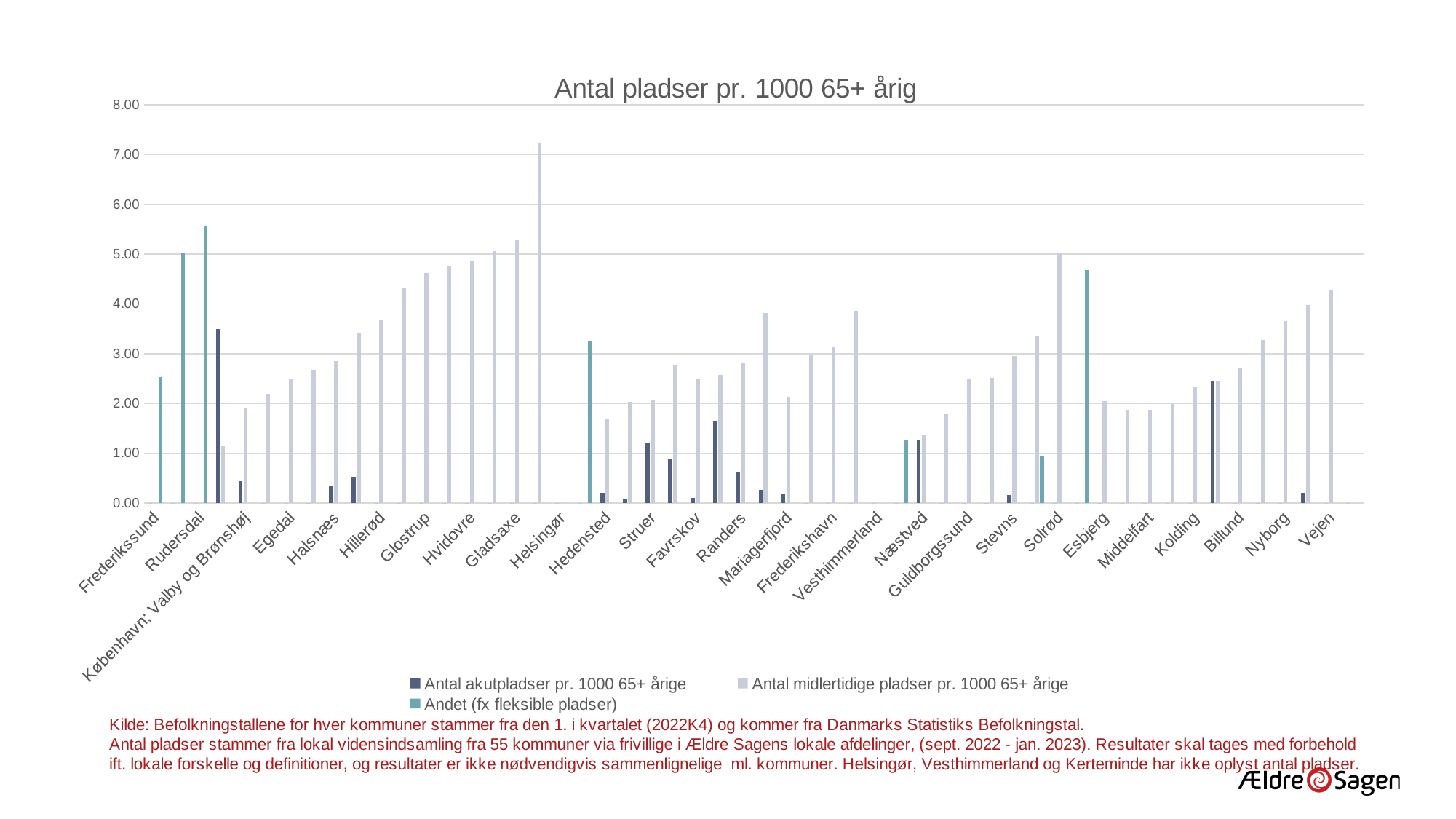
Is the value for Frederikssund greater or less than 2.00? greater Which is larger, the value for Frederikssund or the value for Vejen? Vejen Is the value for Frederikssund greater or less than 3.00? less How many series does the legend list? 3 Which series contains the tallest bar in the chart? Antal midlertidige pladser pr. 1000 65+ årige Which series is shown in teal in the legend? Andet (fx fleksible pladser) What kind of chart is shown on the slide? Bar chart Is the value for Vejen greater or less than 4.00? greater What is the highest value shown on the y axis? 8.00 What is the title of the chart? Antal pladser pr. 1000 65+ årig